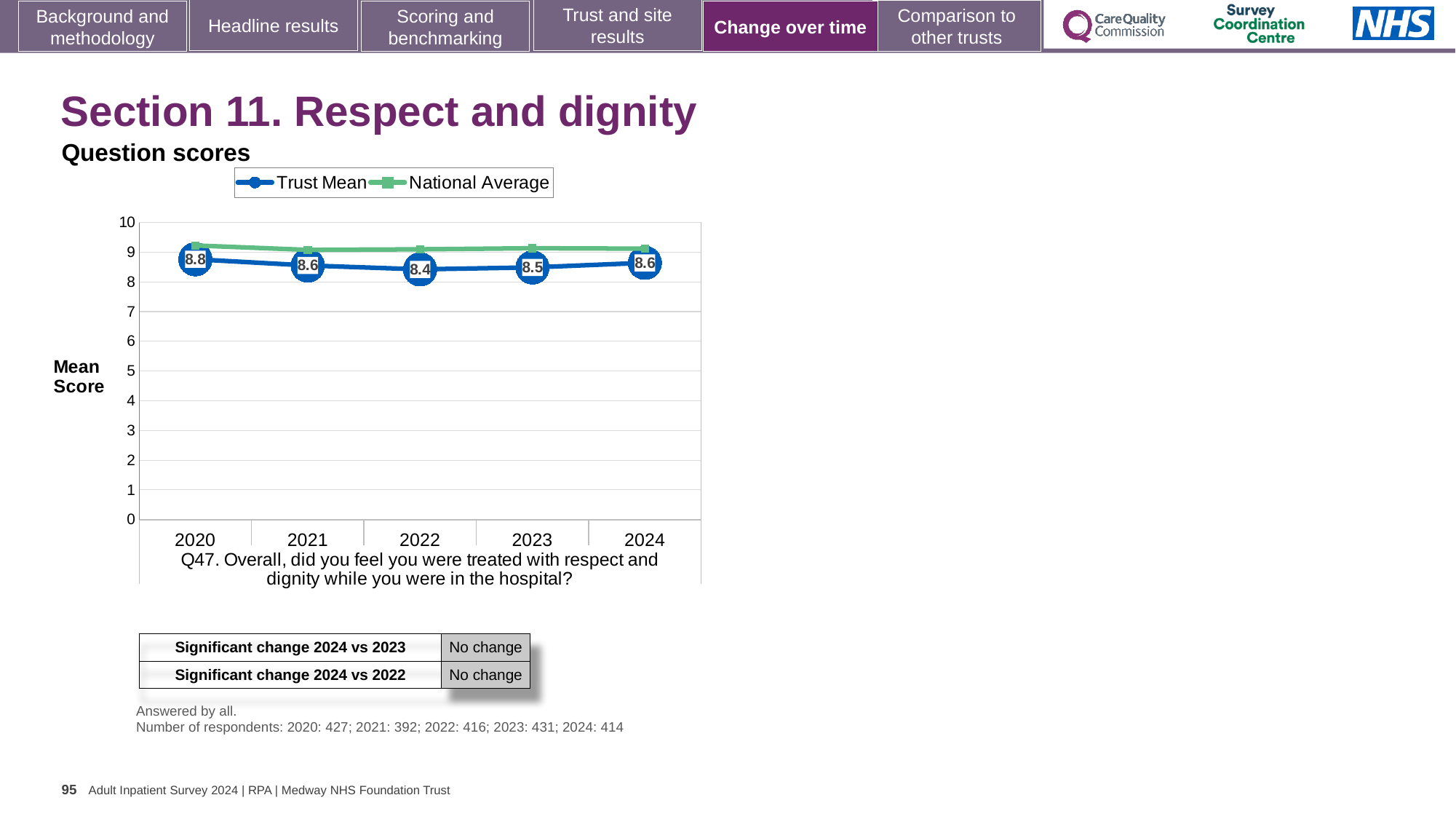
What is the Trust Mean score for 2024? 8.6 What kind of chart is shown on the slide? line chart What is the Trust Mean score for 2020? 8.8 Which is larger, the Trust Mean score for 2021 or for 2023? 2021 How many years are shown on the x axis of the chart? 5 What is the difference between the Trust Mean score in 2020 and in 2022? 0.4 What is the Trust Mean score for 2022? 8.4 In which year is the Trust Mean score lowest? 2022 In which year is the Trust Mean score highest? 2020 How many series does the chart legend list? 2 Is the National Average value for 2020 greater or less than 9? greater Which series is shown in green in the chart? National Average